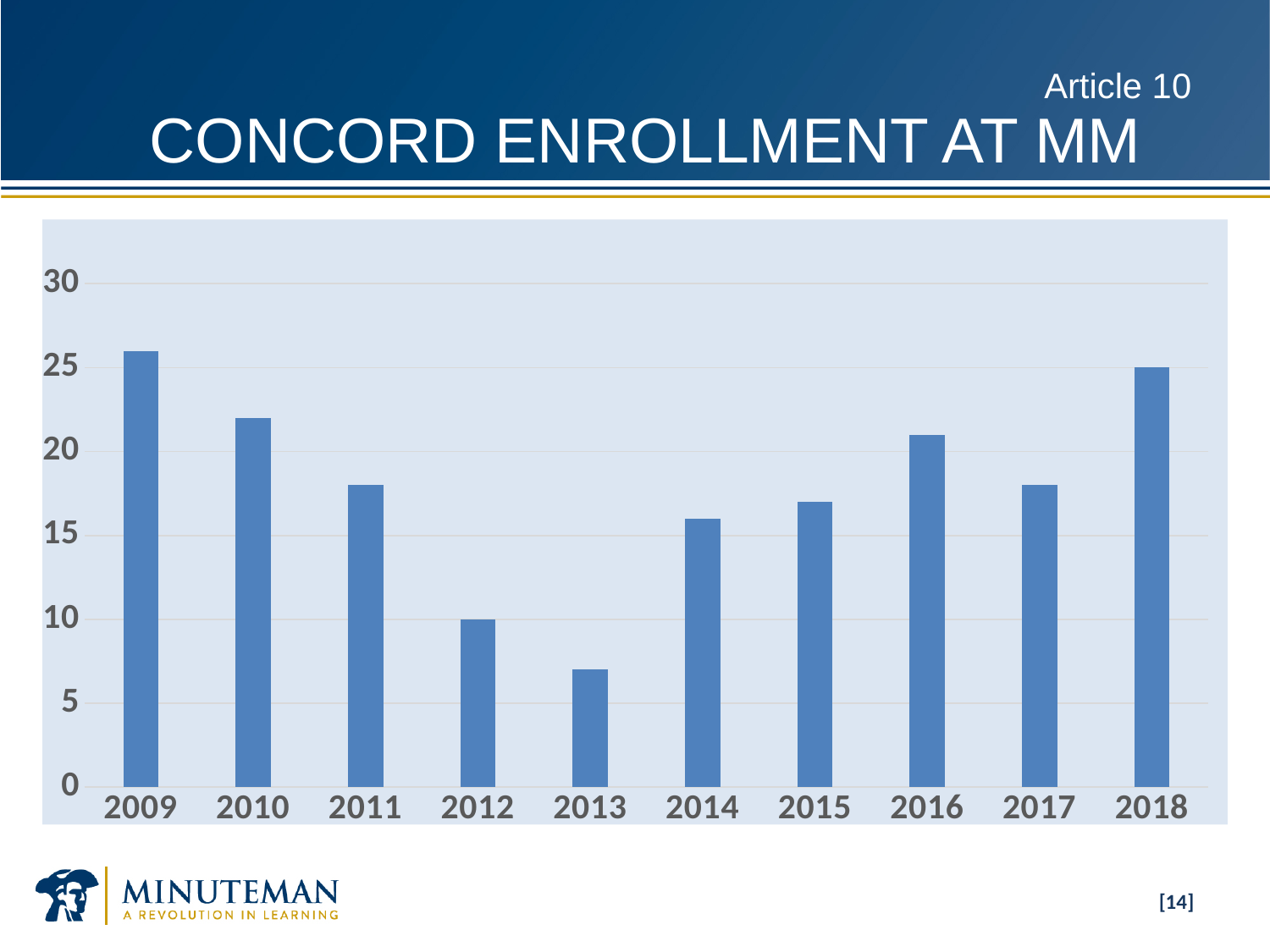
Do the values rise or fall from 2009 to 2013? fall How many years are shown on the x axis of the chart? 10 What type of chart is shown on the slide? bar chart Which year has the larger value, 2010 or 2011? 2010 What is the enrollment value for 2018? 25 Which year has the highest enrollment in the chart? 2009 What is the enrollment value for 2012? 10 Is the value for 2016 greater or less than 20? greater Is the value for 2009 greater or less than 25? greater Is the value for 2013 greater or less than 10? less Which year has the lowest enrollment in the chart? 2013 What is the title of the slide containing the chart? CONCORD ENROLLMENT AT MM